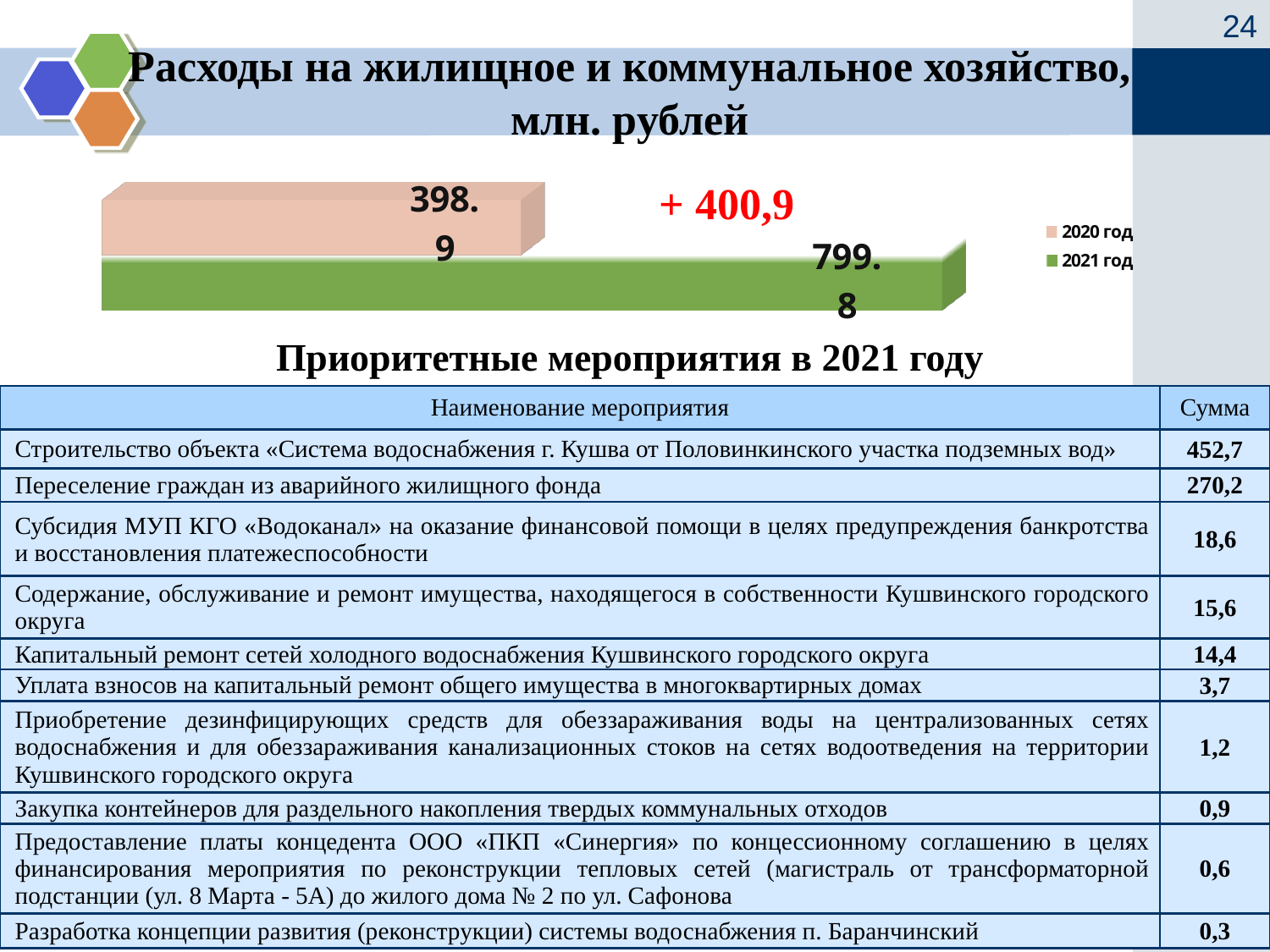
Is the value for 2021 год larger or smaller than the value for 2020 год? larger What is the difference between the 2021 год and 2020 год values in the chart? 400.9 How many bars are plotted in the chart? 2 Which year has the lower value in the chart? 2020 год What type of chart is shown on the slide? bar chart What is the value for 2021 год in the chart? 799.8 What is the title of the chart on the slide? Расходы на жилищное и коммунальное хозяйство, млн. рублей What is the value for 2020 год in the chart? 398.9 What change is annotated in red between the two bars of the chart? + 400,9 How many series does the chart legend list? 2 Which year has the higher value in the chart? 2021 год